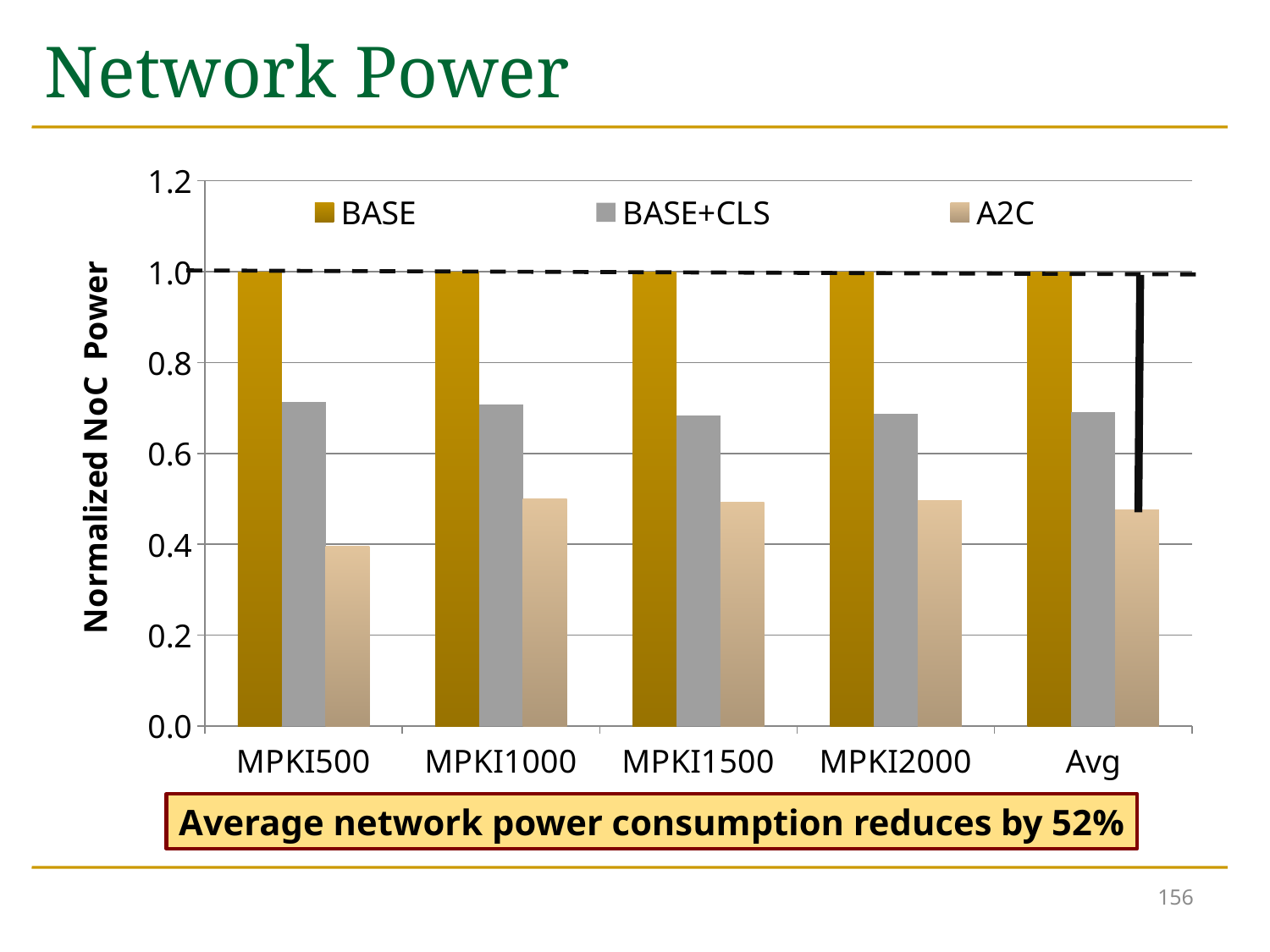
Is the value of BASE+CLS for Avg greater or less than 0.8? less For which category is the A2C value lowest? MPKI500 What kind of chart is shown on the slide? bar chart What is the title of the y axis? Normalized NoC Power For MPKI1500, which is larger: BASE+CLS or A2C? BASE+CLS What is the value of BASE for Avg? 1.0 How many series does the legend list? 3 What is the value of BASE for MPKI500? 1.0 Is the value of A2C for MPKI500 greater or less than 0.6? less Is the value of BASE+CLS for MPKI500 greater or less than 0.6? greater How many categories are shown on the x axis? 5